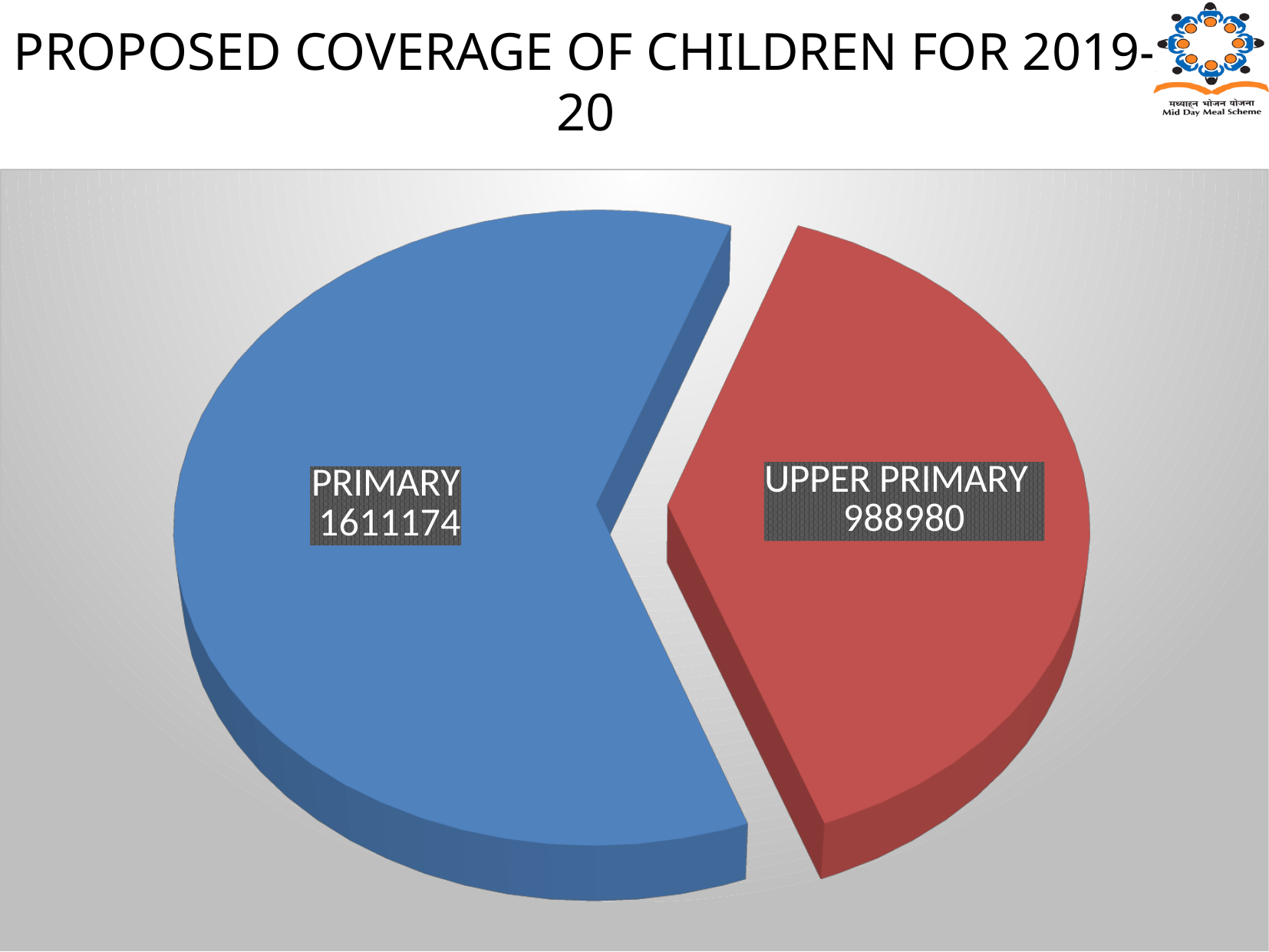
What is the value for PRIMARY? 1611174 What is the total of the two slices in the pie chart? 2600154 What is the title of the chart slide? PROPOSED COVERAGE OF CHILDREN FOR 2019-20 Which category has the largest slice of the pie? PRIMARY What is the value for UPPER PRIMARY? 988980 Which is larger, the value for PRIMARY or the value for UPPER PRIMARY? PRIMARY What type of chart is shown on the slide? Pie chart What colour is the UPPER PRIMARY slice? Red What is the difference between the PRIMARY and UPPER PRIMARY values? 622194 Which category has the smallest slice of the pie? UPPER PRIMARY How many categories (slices) does the pie chart have? 2